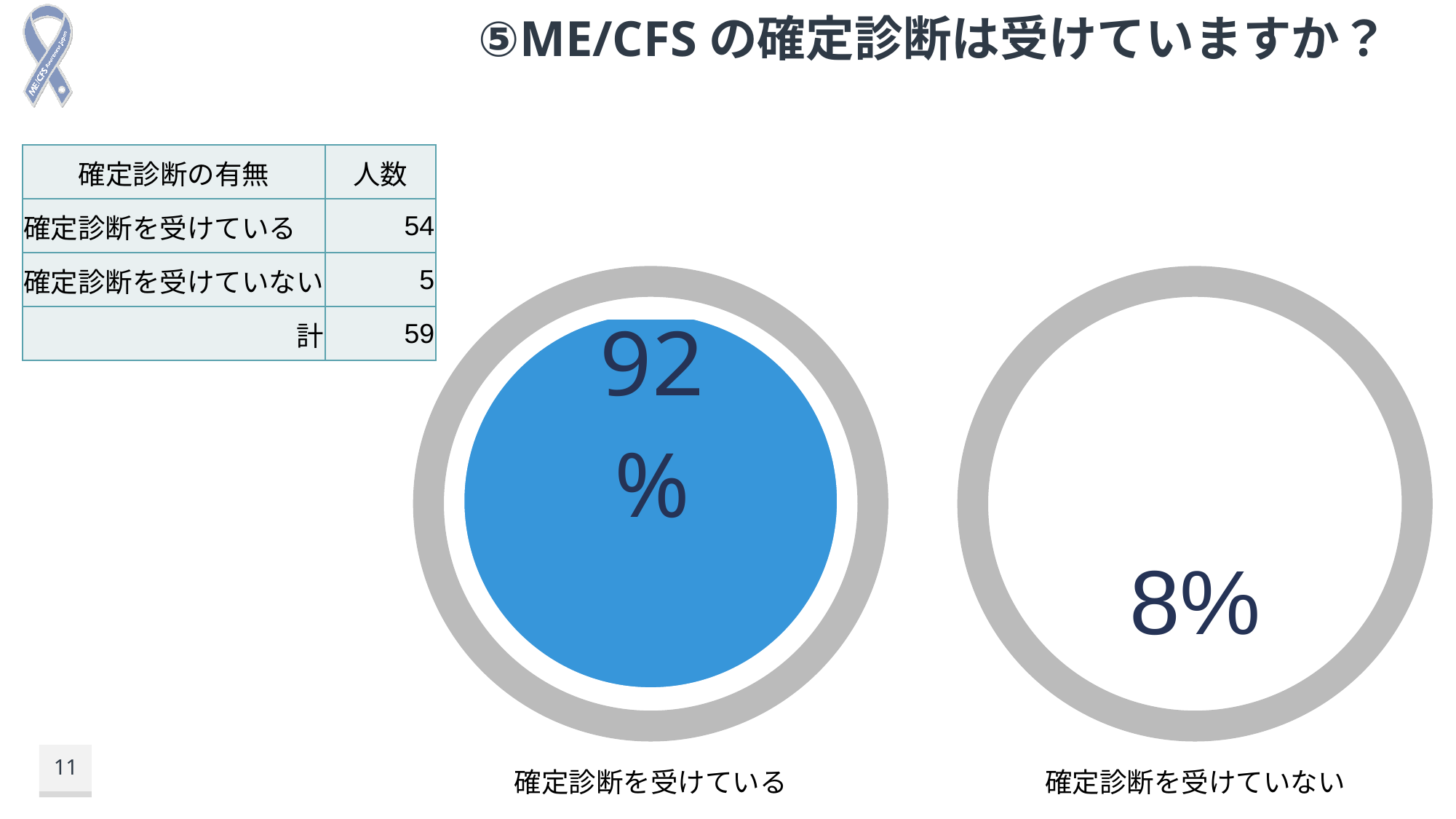
Which of the two circle charts shows the lower percentage, 確定診断を受けている or 確定診断を受けていない? 確定診断を受けていない Which of the two circle charts shows the higher percentage, 確定診断を受けている or 確定診断を受けていない? 確定診断を受けている According to the table on the slide, how many people are in the 確定診断を受けていない category? 5 According to the table on the slide, what is the total (計) number of people? 59 What colour is the filled inner circle of the 確定診断を受けている chart? blue Is the percentage for 確定診断を受けている larger or smaller than the percentage for 確定診断を受けていない? larger What percentage is shown in the left circle chart labelled 確定診断を受けている? 92% According to the table on the slide, how many people are in the 確定診断を受けている category? 54 What is the title of the slide containing the circle charts? ⑤ME/CFS の確定診断は受けていますか？ What percentage is shown in the right circle chart labelled 確定診断を受けていない? 8% What is the difference in percentage points between the 確定診断を受けている circle and the 確定診断を受けていない circle? 84 How many circle charts are shown on the slide? 2